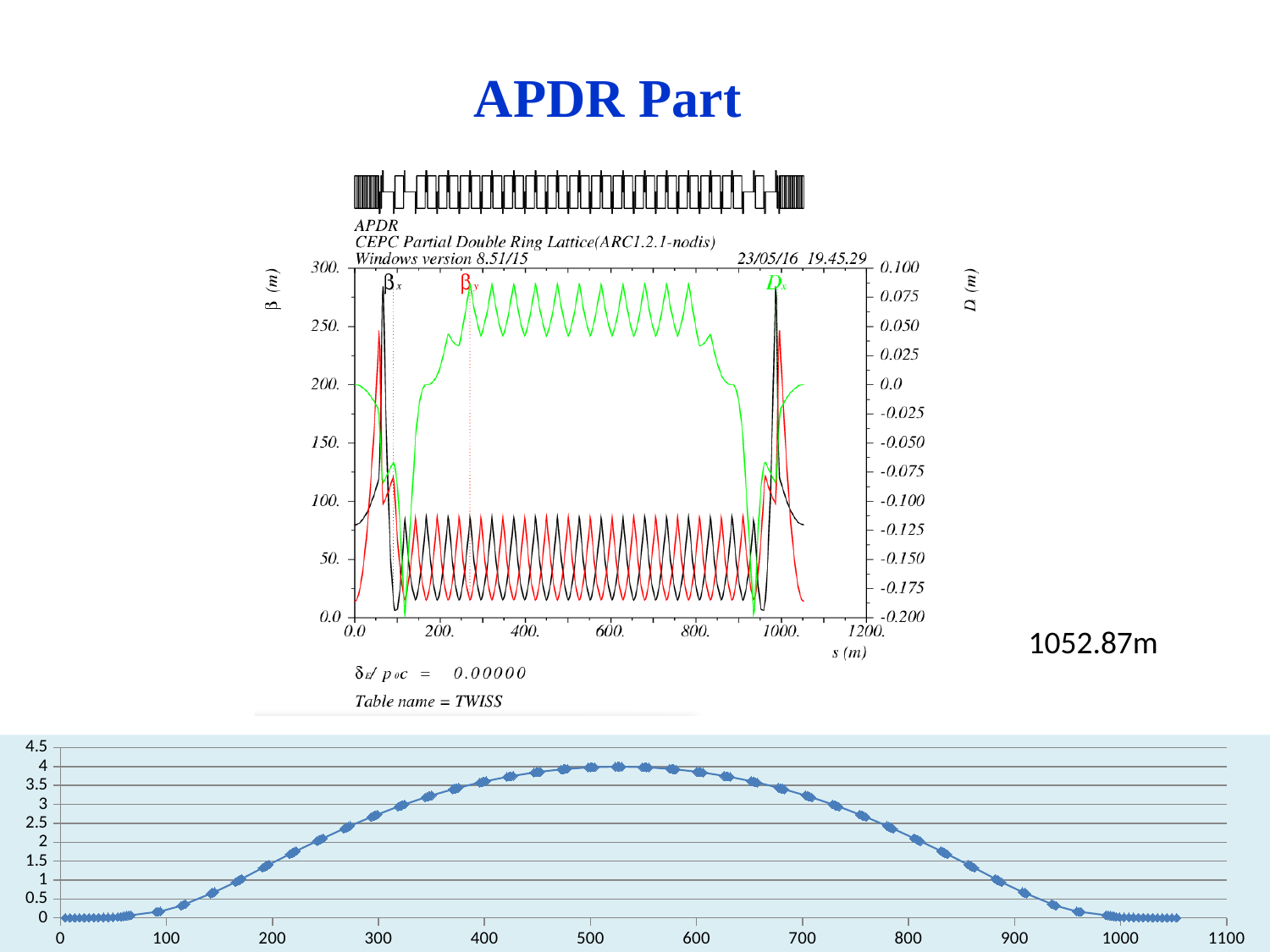
In the bottom chart, is the value at x = 500 greater or less than 3.5? greater In the bottom chart, is the value at x = 1000 greater or less than 0.5? less In the top chart, is the peak value of βx greater or less than 250? greater In the bottom chart, do the values rise or fall as x goes from 100 to 500? rise In the bottom chart, do the values rise or fall as x goes from 600 to 1000? fall What is the title printed on the top chart? CEPC Partial Double Ring Lattice(ARC1.2.1-nodis) How many curves (series) are labelled in the top chart? 3 What kind of chart is the chart at the bottom of the slide? line chart In the bottom chart, what is the highest value shown on the vertical axis? 4.5 What kind of chart is the top chart? line chart